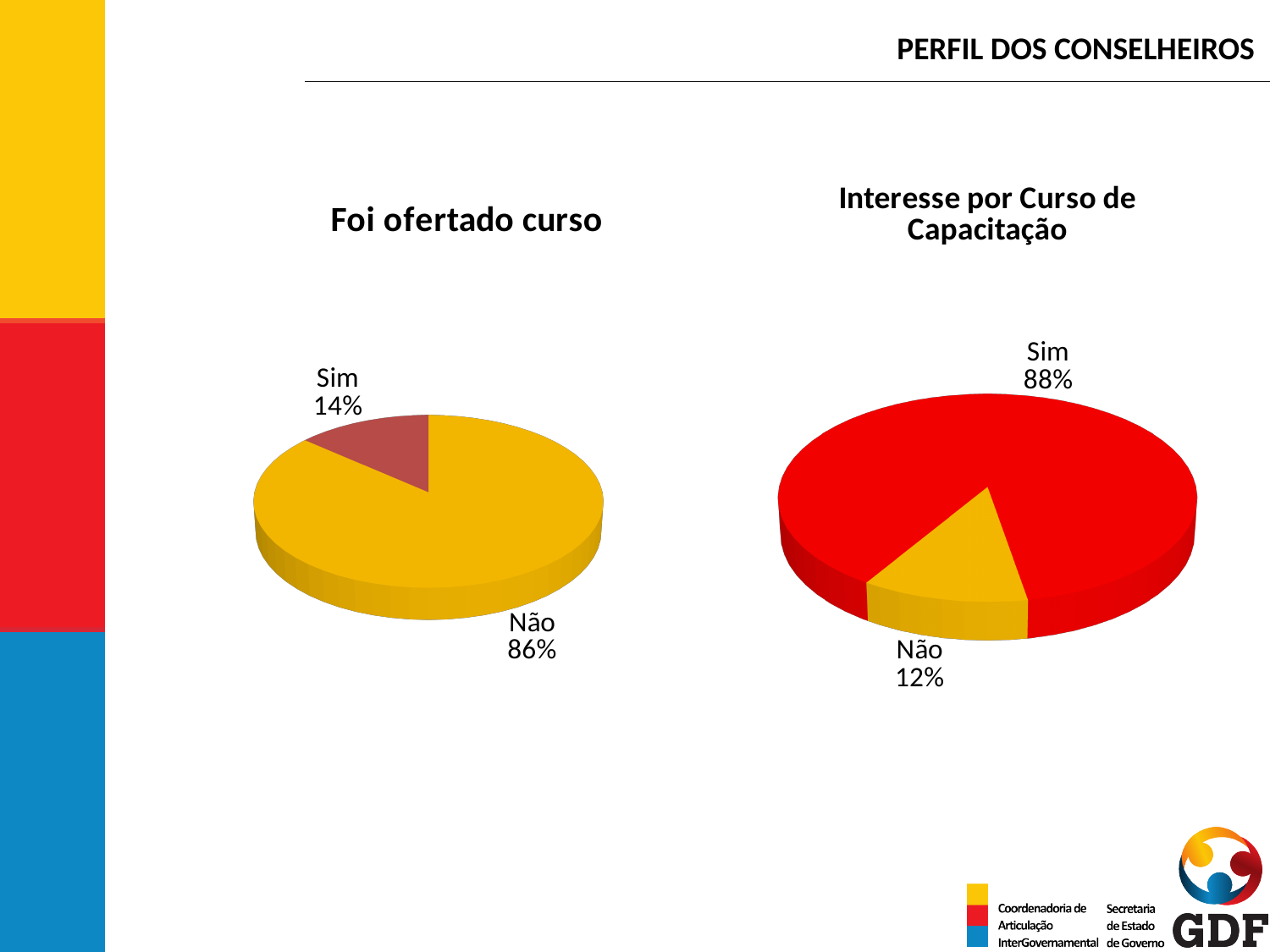
In the 'Foi ofertado curso' chart, what is the difference in percentage points between 'Não' and 'Sim'? 72 In the 'Interesse por Curso de Capacitação' chart, what is the difference in percentage points between 'Sim' and 'Não'? 76 How many slices does the 'Interesse por Curso de Capacitação' chart have? 2 In the 'Foi ofertado curso' chart, which category has the largest slice? Não In the 'Foi ofertado curso' chart, what percentage is shown for 'Sim'? 14% In the 'Interesse por Curso de Capacitação' chart, what percentage is shown for 'Sim'? 88% What type of chart is the 'Foi ofertado curso' chart? Pie chart In the 'Interesse por Curso de Capacitação' chart, which category has the smallest slice? Não What is the title of the chart on the right side of the slide? Interesse por Curso de Capacitação In the 'Interesse por Curso de Capacitação' chart, what percentage is shown for 'Não'? 12% In the 'Foi ofertado curso' chart, what percentage is shown for 'Não'? 86% Which is larger: 'Sim' in the 'Foi ofertado curso' chart or 'Não' in the 'Interesse por Curso de Capacitação' chart? Sim in Foi ofertado curso